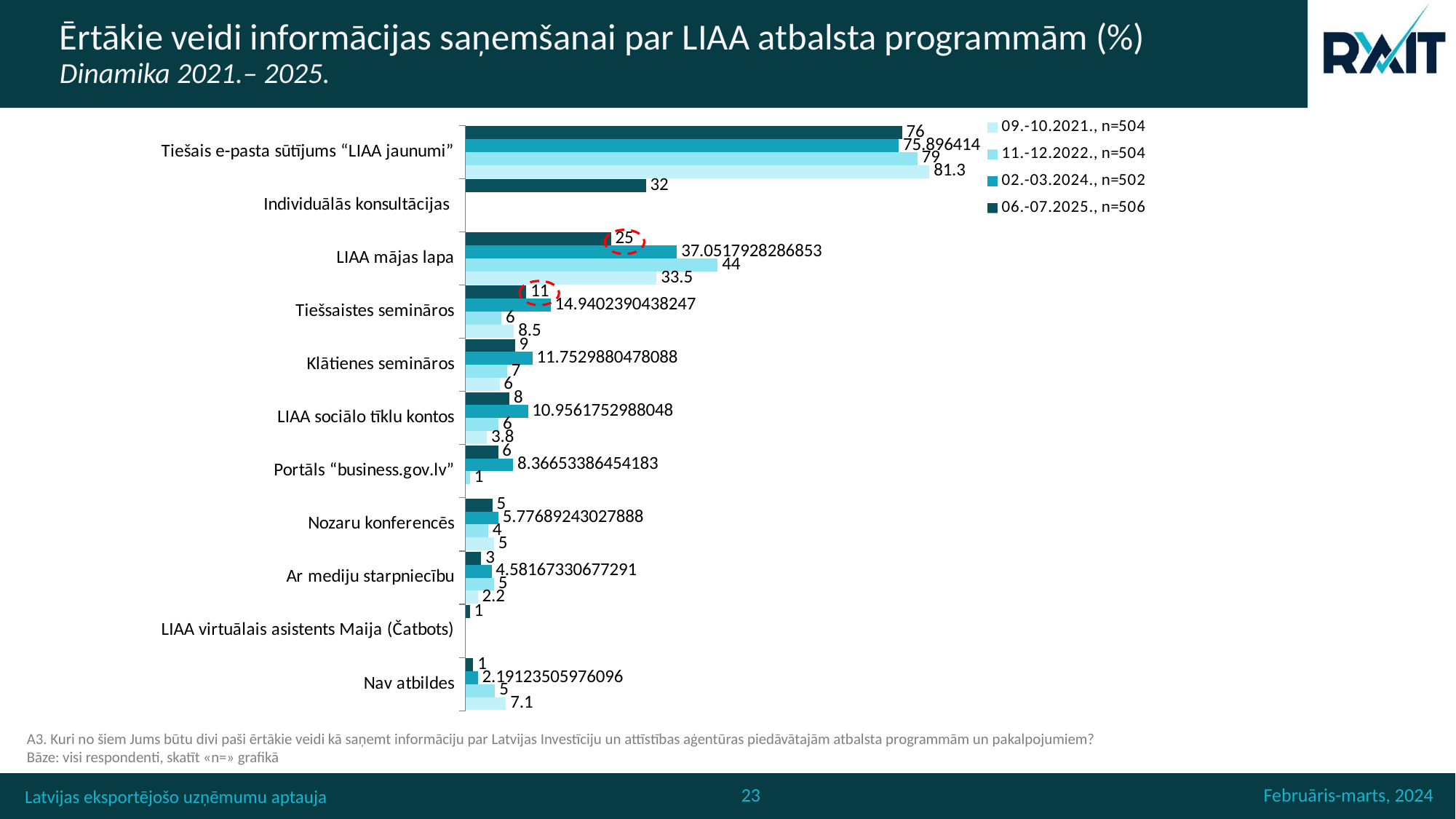
How many series does the legend list? 4 What kind of chart is shown on the slide? bar chart What is the difference between the 11.-12.2022. value and the 06.-07.2025. value for LIAA mājas lapa? 19 What is the value for LIAA mājas lapa in the 11.-12.2022. series? 44 Does the value for Nav atbildes rise or fall from the 2021 series to the 2025 series? fall What is the value for Tiešais e-pasta sūtījums "LIAA jaunumi" in the 09.-10.2021. series? 81.3 For Tiešsaistes semināros, which is larger: the 06.-07.2025. value or the 11.-12.2022. value? 06.-07.2025. What sample size (n) does the legend give for the 06.-07.2025. series? n=506 How many categories are shown on the chart? 11 What is the value for Nav atbildes in the 09.-10.2021. series? 7.1 Which category has the highest value in the 06.-07.2025. series? Tiešais e-pasta sūtījums "LIAA jaunumi" What is the value for Individuālās konsultācijas in the 06.-07.2025. series? 32